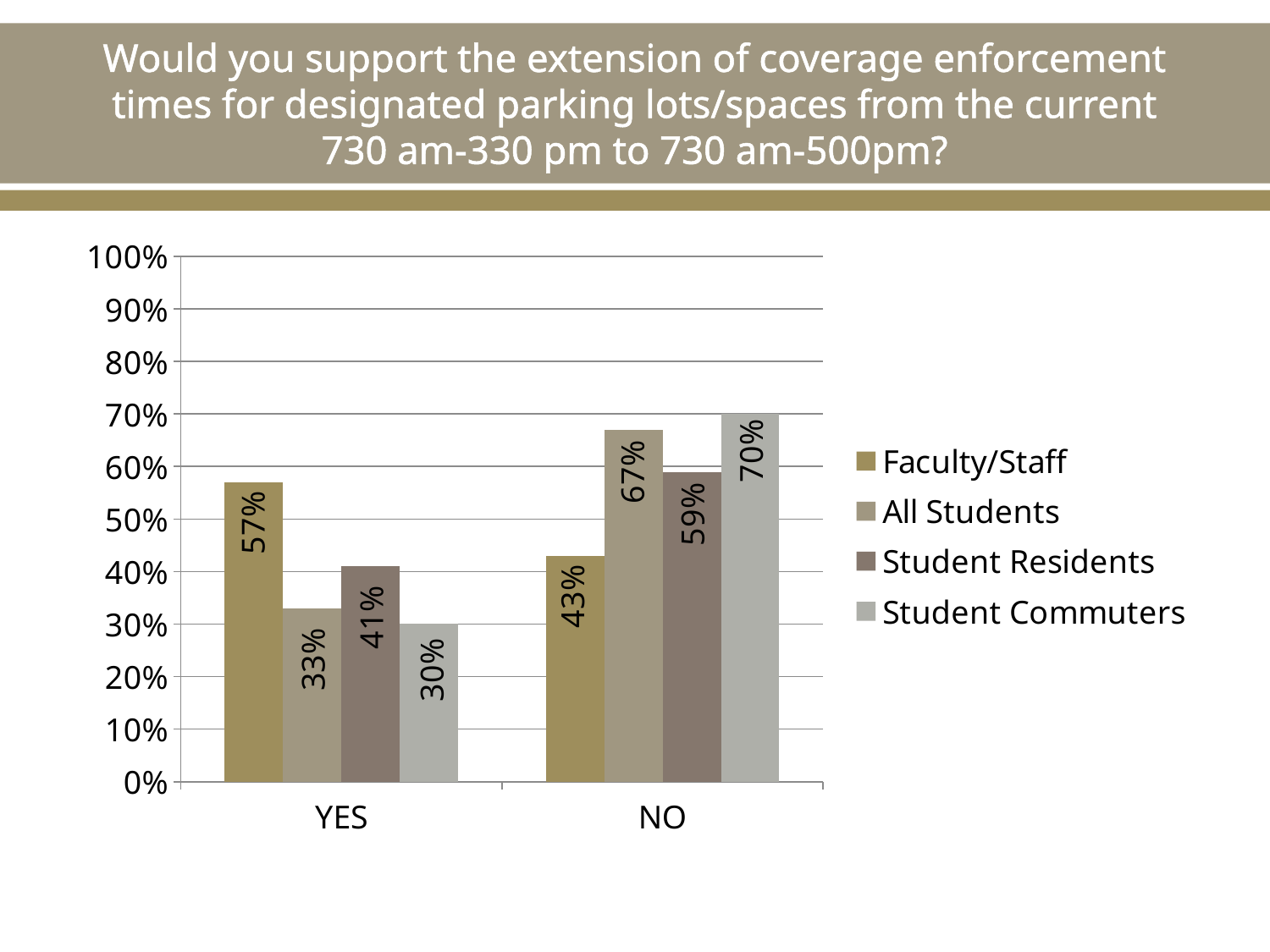
What is the difference between the Student Commuters NO percentage and their YES percentage? 40% What percentage of All Students answered NO? 67% How many series does the legend list? 4 Which group has the highest percentage answering YES? Faculty/Staff What percentage of Student Residents answered YES? 41% How many categories are shown on the x axis? 2 What percentage of Faculty/Staff answered YES? 57% What kind of chart is shown on the slide? Bar chart Which is larger: the All Students YES percentage or the Student Residents YES percentage? Student Residents What percentage of Student Commuters answered NO? 70% What is the difference between the Faculty/Staff YES and NO percentages? 14% Which group has the lowest percentage answering NO? Faculty/Staff